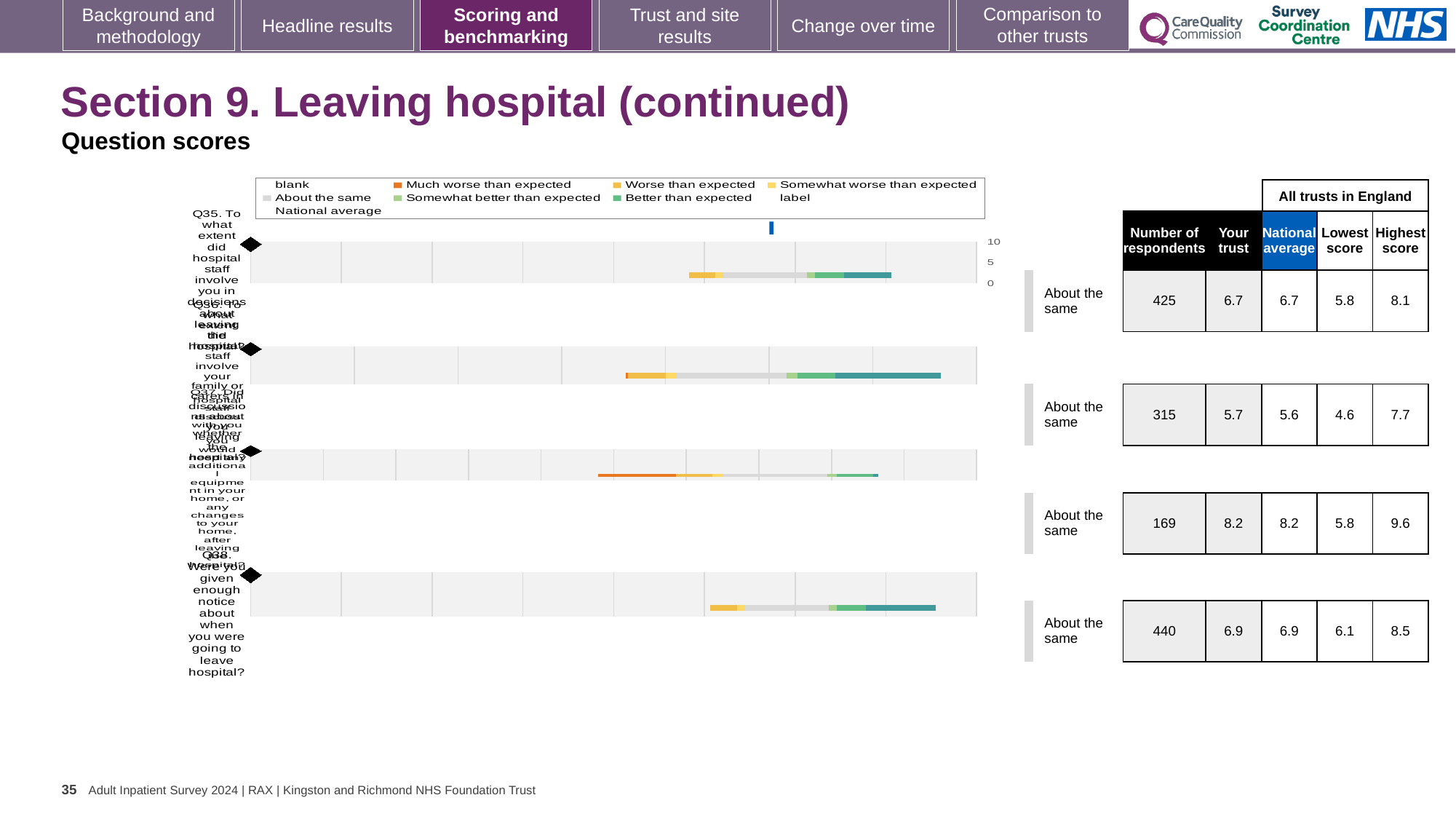
In the table beside the charts, how many respondents are listed for Q38? 440 For Q36, which is larger: the 'Your trust' score or the national average? Your trust Which question has the highest 'Your trust' score in the table beside the charts? Q37 In the table beside the charts, what is the 'Your trust' score for Q35 (involving you in decisions about leaving hospital)? 6.7 What benchmark category is shown next to each of the four question charts? About the same In the table beside the charts, how many respondents are listed for Q36 (involving family or carers in discussions about leaving hospital)? 315 For Q37, what is the difference between the highest score (9.6) and the lowest score (5.8) across all trusts in England? 3.8 How many question score charts are shown on the slide? 4 What kind of chart is used to show the question scores on this slide? bar chart What colour does the legend use for 'Much worse than expected'? orange In the table beside the charts, what is the highest score across all trusts in England for Q38 (enough notice about leaving hospital)? 8.5 Which question has the lowest 'Your trust' score in the table beside the charts? Q36